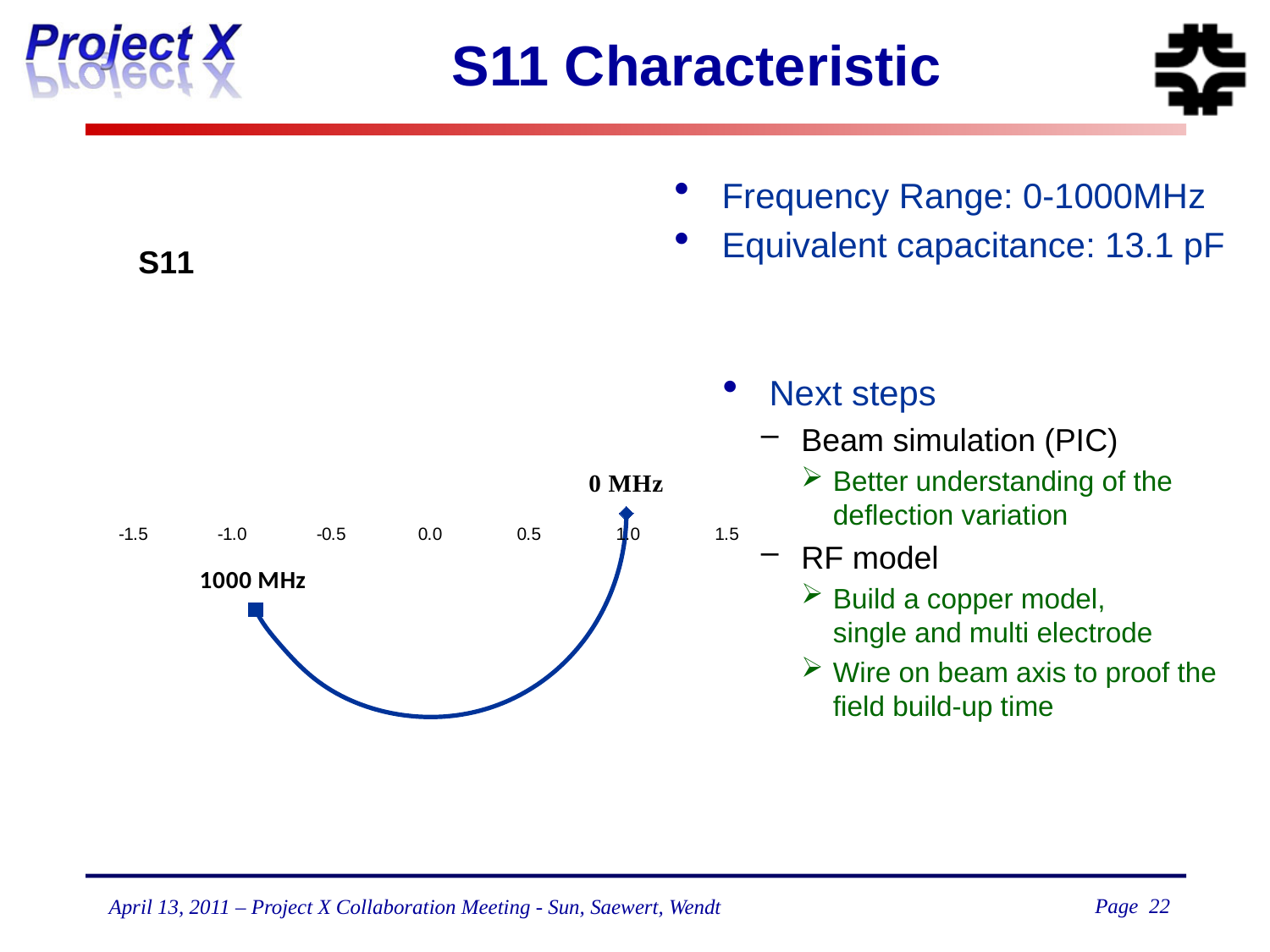
Is the horizontal-axis value of the 1000 MHz point greater or less than 0.0? less What are the lowest and highest tick values shown on the horizontal axis of the S11 chart? -1.5 and 1.5 Is the horizontal-axis value of the 1000 MHz point greater or less than -0.5? less At what horizontal-axis value does the 0 MHz point of the S11 curve lie? 1.0 What kind of chart is shown on the slide? scatter chart How many frequency points are labelled on the S11 curve? 2 Is the horizontal-axis value of the 0 MHz point greater or less than 0.5? greater Which labelled point on the S11 curve has the smaller horizontal-axis value? 1000 MHz As frequency increases from 0 MHz to 1000 MHz, does the S11 curve move to the left or to the right along the horizontal axis? left Which two frequencies are labelled on the S11 curve? 0 MHz and 1000 MHz What is the title of the chart on the slide? S11 Which labelled point on the S11 curve has the larger horizontal-axis value, 0 MHz or 1000 MHz? 0 MHz